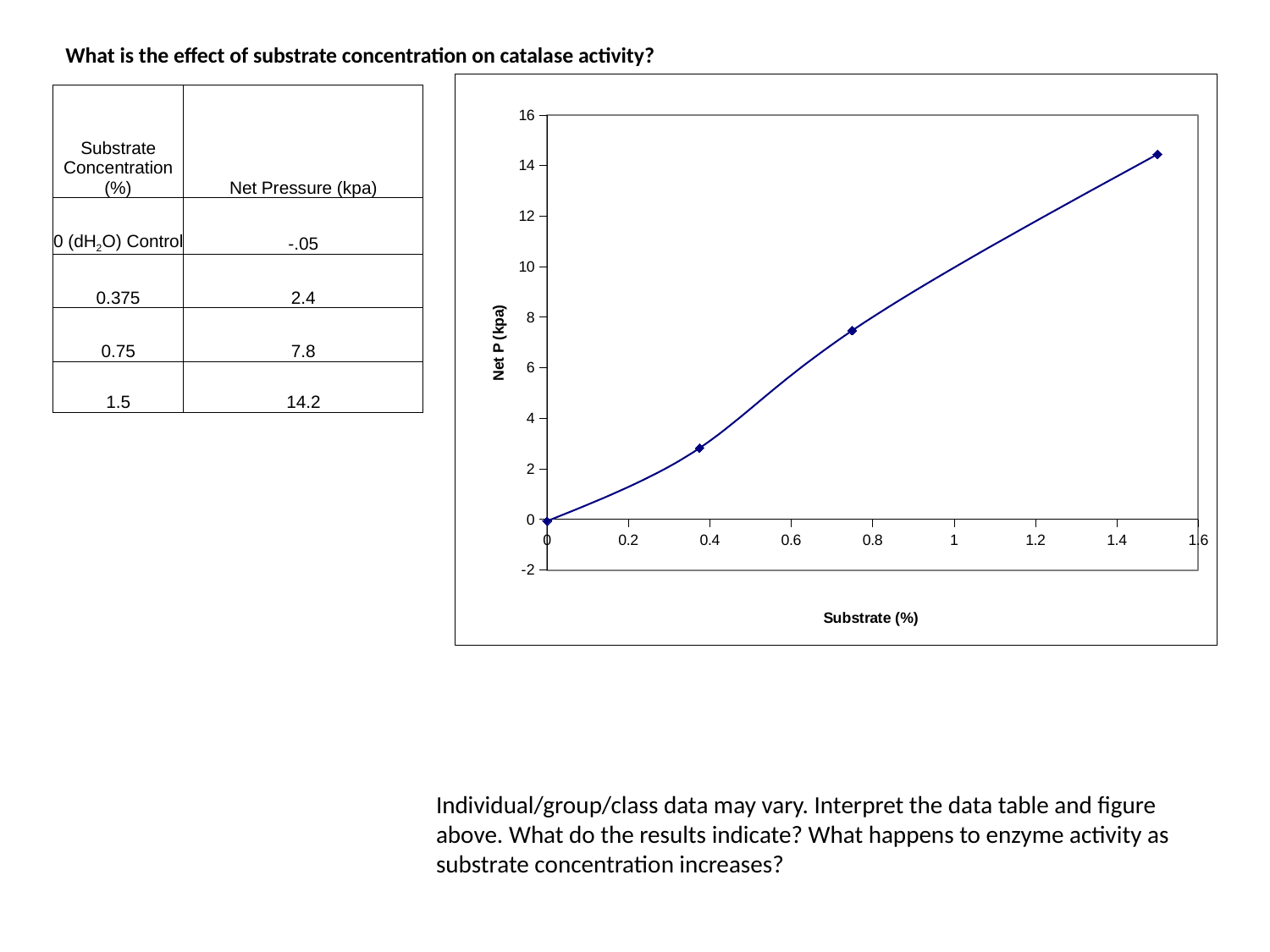
What is the title of the chart's y axis? Net P (kpa) What is the title of the chart's x axis? Substrate (%) Is the net pressure at substrate concentration 1.5% greater or less than 14 kpa on the chart? greater Do the values on the chart rise or fall as substrate concentration increases along the x axis? rise What kind of chart is shown on the slide? line chart Is the net pressure at substrate concentration 0.75% greater or less than 8 kpa on the chart? less According to the data table, what is the net pressure (kpa) at a substrate concentration of 0.75%? 7.8 Which substrate concentration has the lowest net pressure on the chart? 0 Which substrate concentration has the highest net pressure on the chart? 1.5 Is the net pressure at substrate concentration 0.375% greater or less than 2 kpa on the chart? greater Which has a larger net pressure on the chart, substrate concentration 0.75% or 0.375%? 0.75 How many data points are plotted on the chart? 4